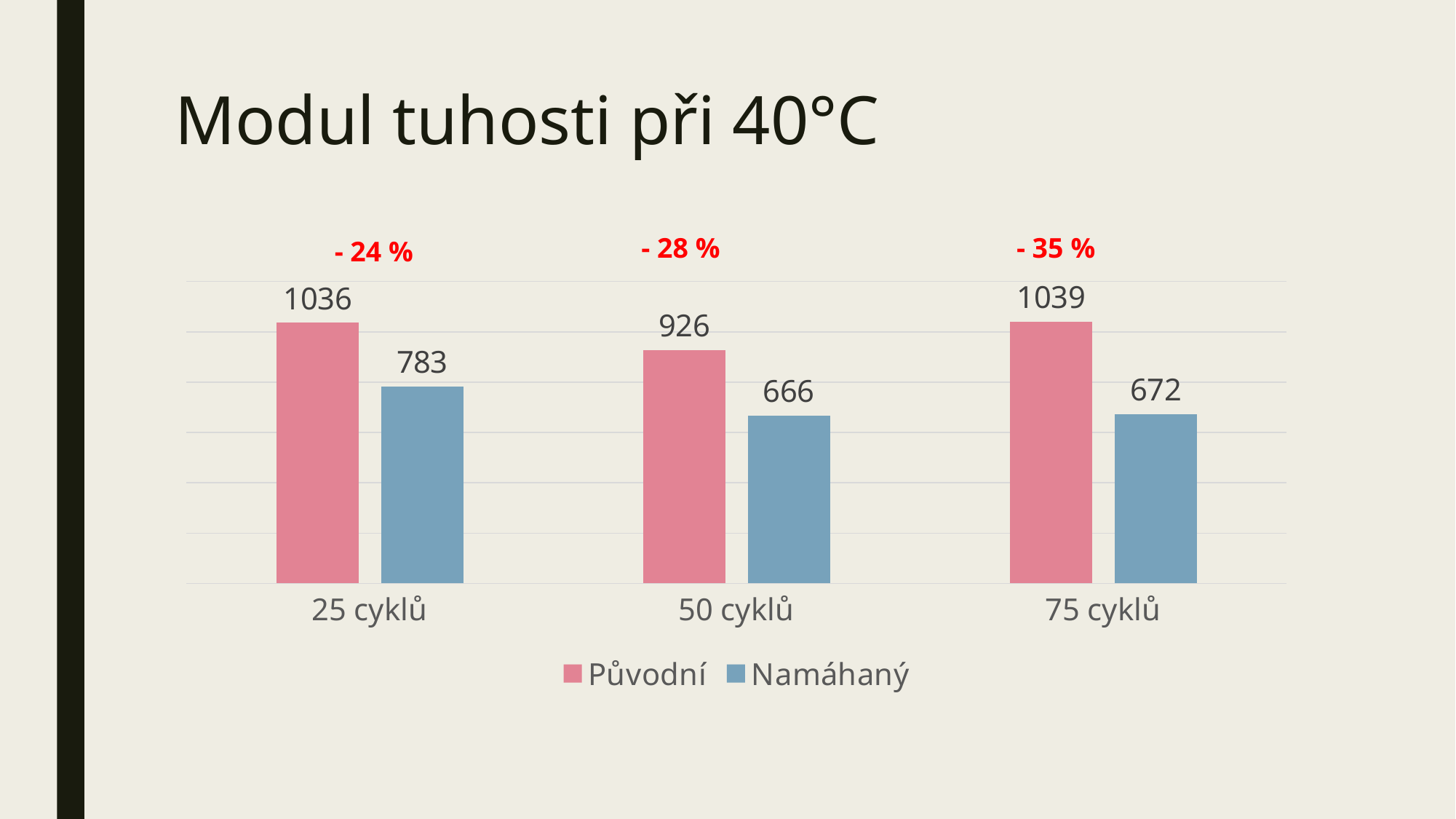
What is the value of Původní for 25 cyklů? 1036 How many series does the legend list? 2 What is the value of Původní for 75 cyklů? 1039 Which category has the lowest Původní value? 50 cyklů What is the difference between Původní and Namáhaný for 75 cyklů? 367 How many categories are shown on the x axis? 3 Which is larger for 50 cyklů, Původní or Namáhaný? Původní What is the value of Namáhaný for 75 cyklů? 672 Which category has the lowest Namáhaný value? 50 cyklů What is the value of Namáhaný for 50 cyklů? 666 What kind of chart is shown on the slide? Bar chart What is the difference between Původní and Namáhaný for 25 cyklů? 253